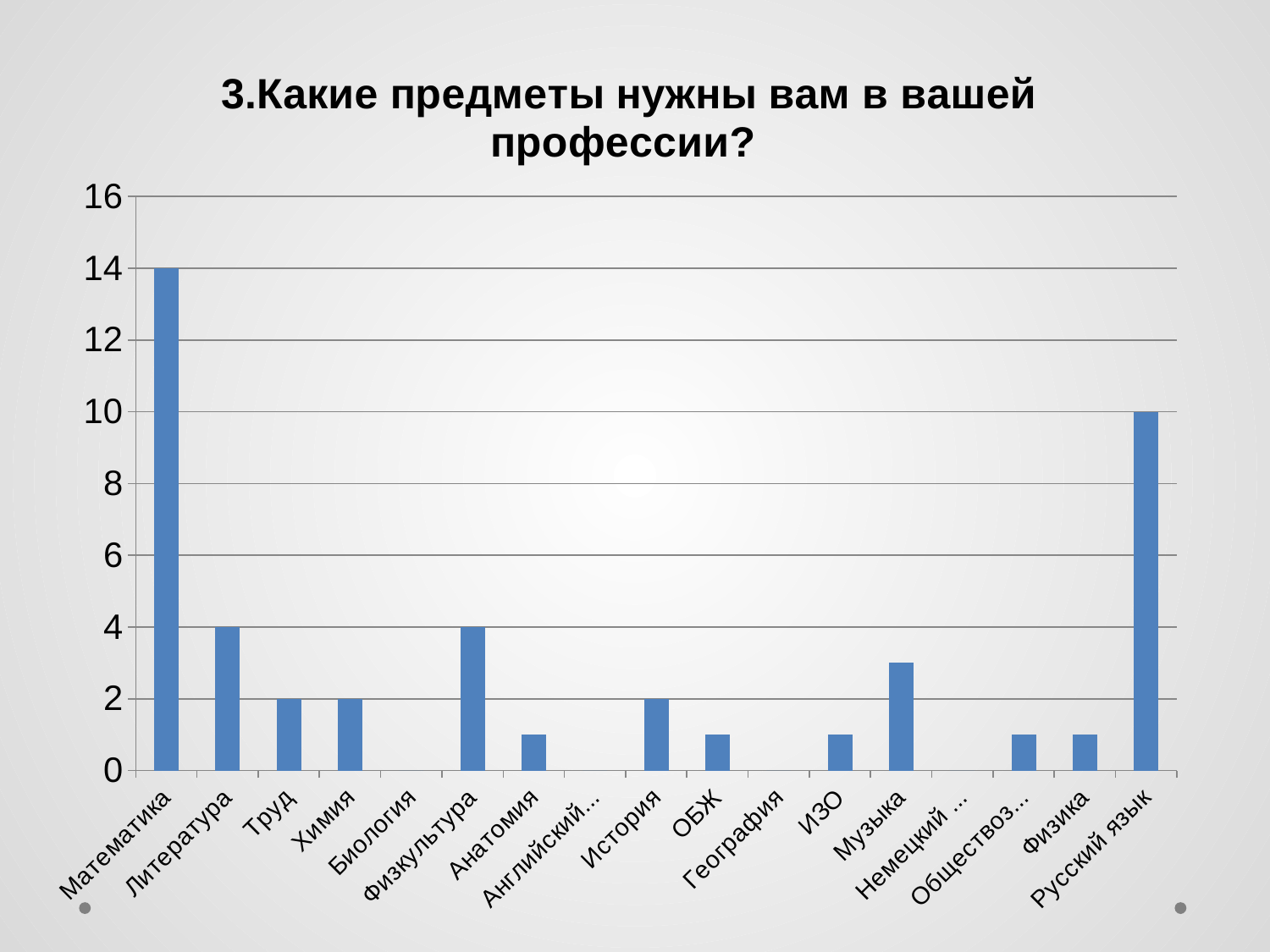
What is the value for История? 2 Is the value for Музыка greater or less than 4? less What is the difference between the values for Литература and Химия? 2 How many categories are shown on the x axis? 17 What is the value for Физкультура? 4 What is the value for Математика? 14 Which is larger, the value for Литература or the value for Труд? Литература What kind of chart is shown on the slide? bar chart What is the value for Русский язык? 10 What is the difference between the values for Математика and Русский язык? 4 Which category has the highest value? Математика Is the value for Русский язык greater or less than 8? greater